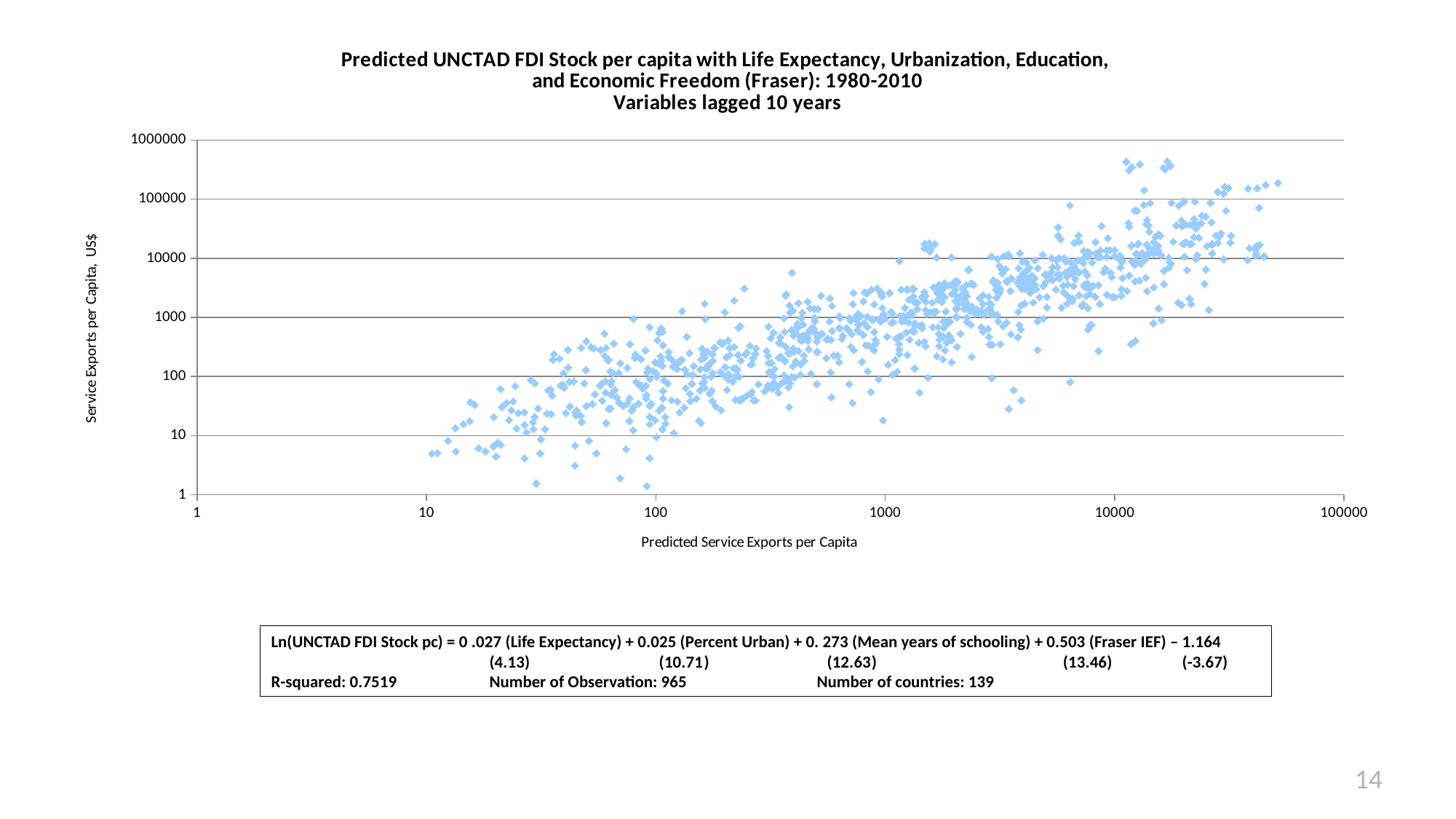
What is the title of the y axis? Service Exports per Capita, US$ What is the highest tick value shown on the y axis? 1000000 What kind of chart is shown on the slide? scatter chart What is the lowest tick value shown on the y axis? 1 What is the title of the x axis? Predicted Service Exports per Capita Do the plotted values generally rise or fall as the x-axis value increases? rise What is the highest tick value shown on the x axis? 100000 What is the lowest tick value shown on the x axis? 1